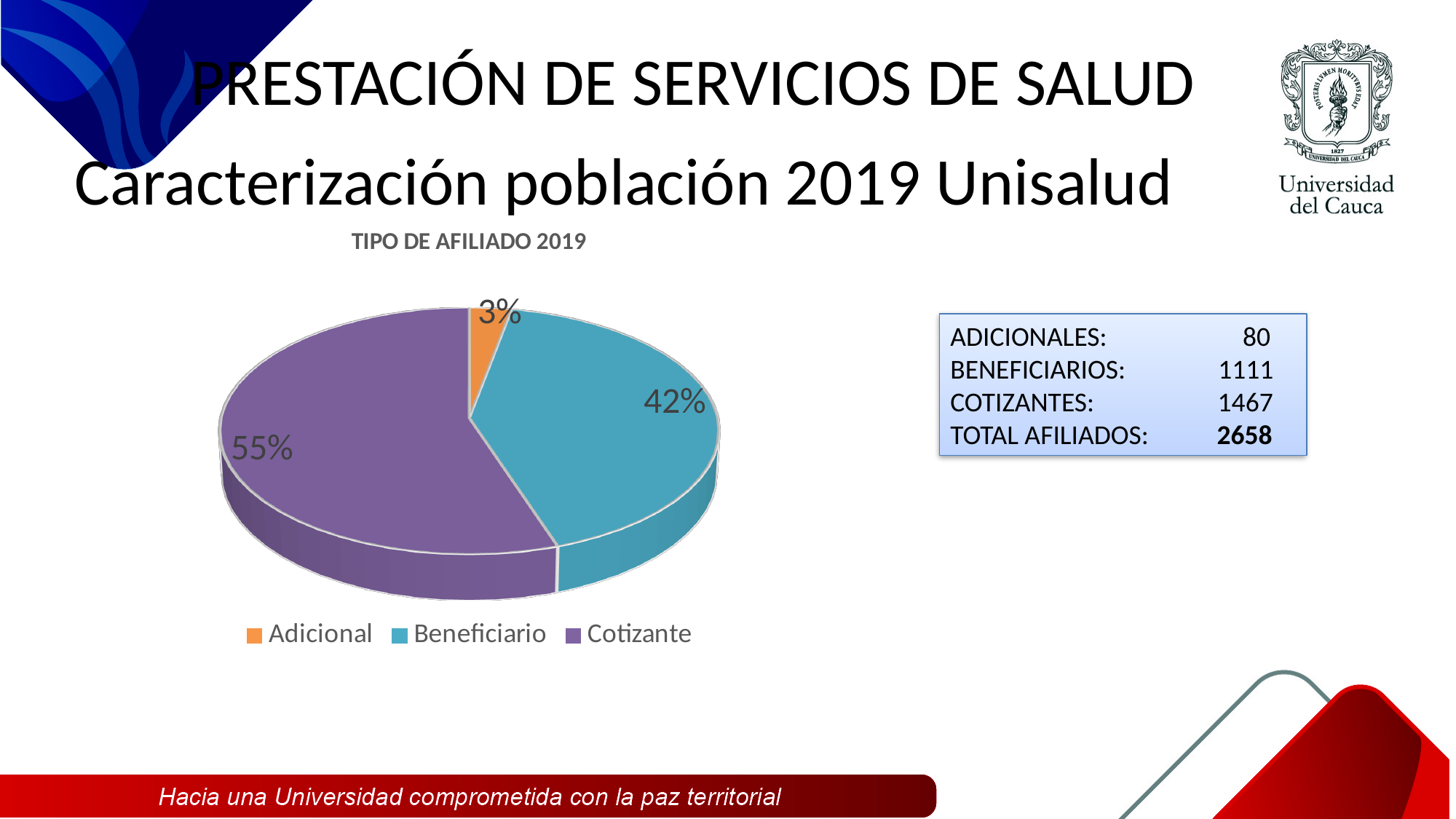
Which slice is larger, Beneficiario or Adicional? Beneficiario Which category has the largest slice of the pie? Cotizante How many entries does the legend list? 3 What is the title of the chart? TIPO DE AFILIADO 2019 What share of the pie does Cotizante represent? 55% What type of chart is shown on the slide? Pie chart What is the difference in percentage points between the Cotizante and Beneficiario slices? 13 What share of the pie does Adicional represent? 3% How many categories does the pie chart show? 3 What colour is the Cotizante slice in the pie chart? Purple Which category has the smallest slice of the pie? Adicional What share of the pie does Beneficiario represent? 42%